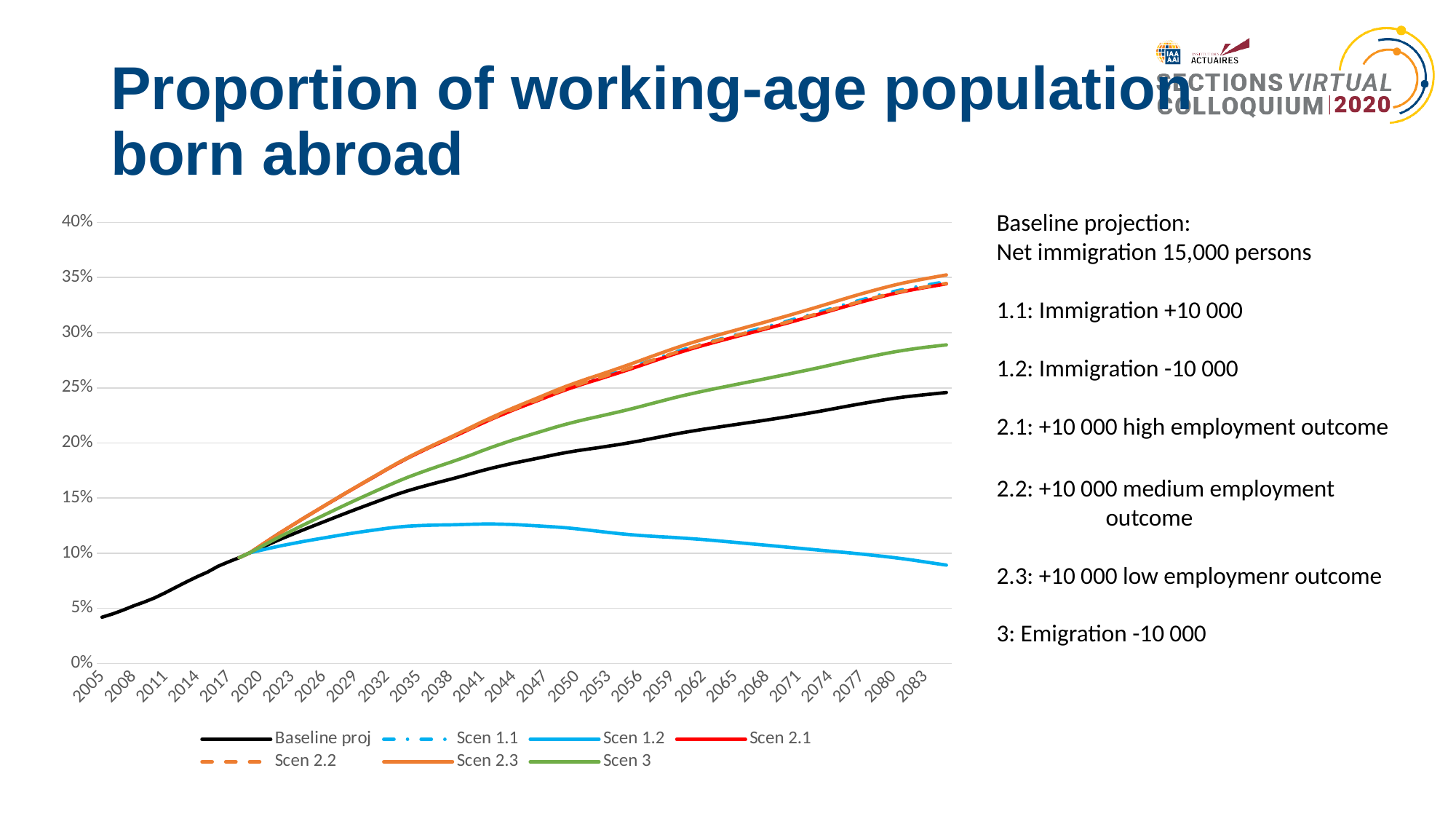
What kind of chart is shown on the slide? Line chart What is the title of the slide containing the chart? Proportion of working-age population born abroad Which is larger in 2083, Scen 3 or Baseline proj? Scen 3 Is the value for Scen 3 in 2083 greater or less than 25%? greater Is the value for Baseline proj in 2083 greater or less than 20%? greater Is the value for Baseline proj in 2005 greater or less than 5%? less Does the Baseline proj series rise or fall from 2005 to 2083? Rises Which series has the lowest value in 2083? Scen 1.2 How many series does the chart legend list? 7 Which series in the chart is drawn as a solid black line? Baseline proj